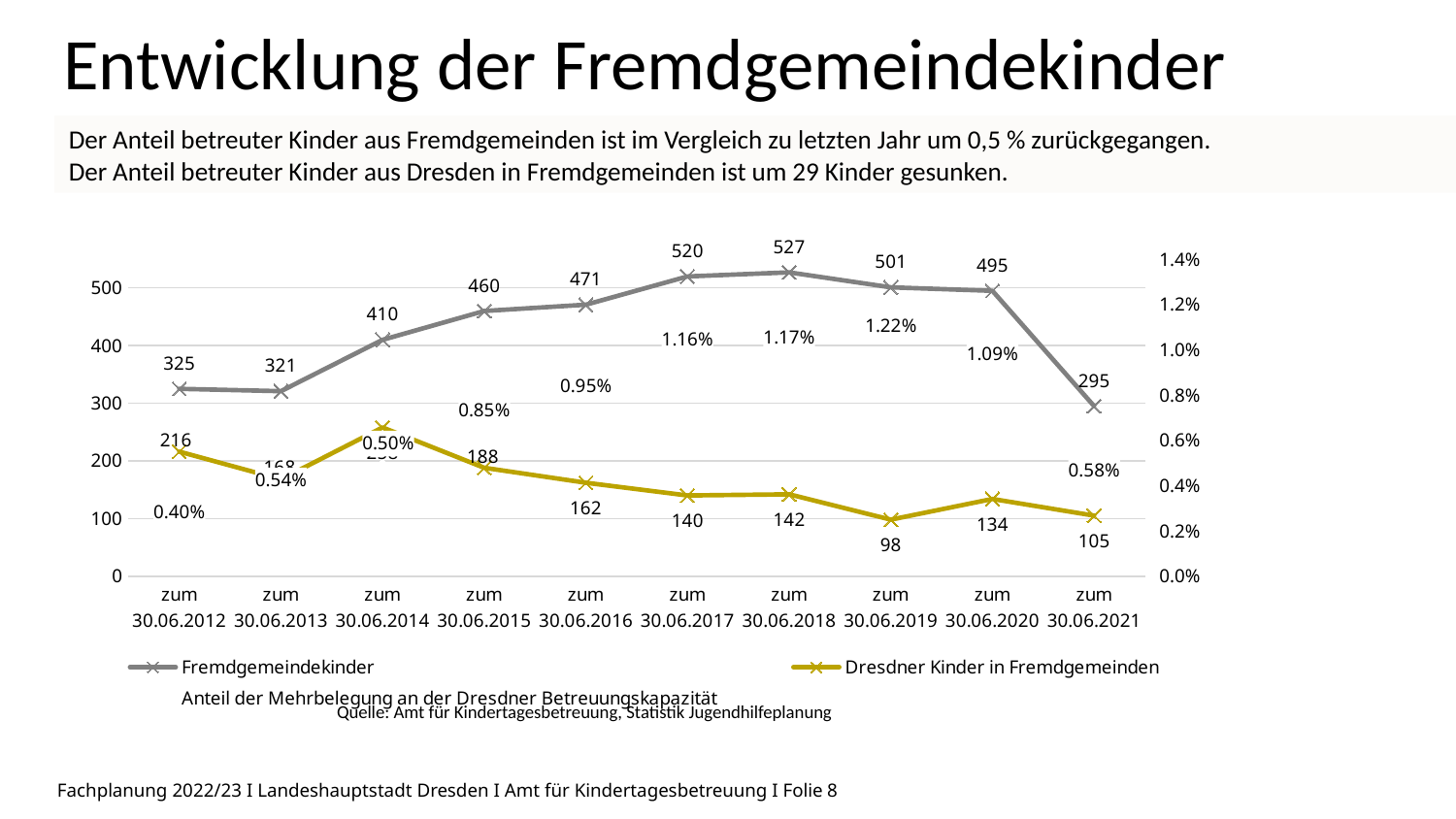
What is the difference between the Fremdgemeindekinder values zum 30.06.2020 and zum 30.06.2021? 200 At which date is the value for Dresdner Kinder in Fremdgemeinden lowest? zum 30.06.2019 What is the value for Dresdner Kinder in Fremdgemeinden zum 30.06.2019? 98 What type of chart is shown on the slide? line chart How many series does the legend list? 3 Which is larger: Fremdgemeindekinder zum 30.06.2015 or zum 30.06.2016? zum 30.06.2016 Does the value for Dresdner Kinder in Fremdgemeinden rise or fall from 30.06.2015 to 30.06.2019? fall At which date is the value for Fremdgemeindekinder highest? zum 30.06.2018 What is the value for Fremdgemeindekinder zum 30.06.2018? 527 How many dates are shown on the x axis? 10 What is the Anteil der Mehrbelegung an der Dresdner Betreuungskapazität zum 30.06.2019? 1.22% What is the value for Fremdgemeindekinder zum 30.06.2021? 295